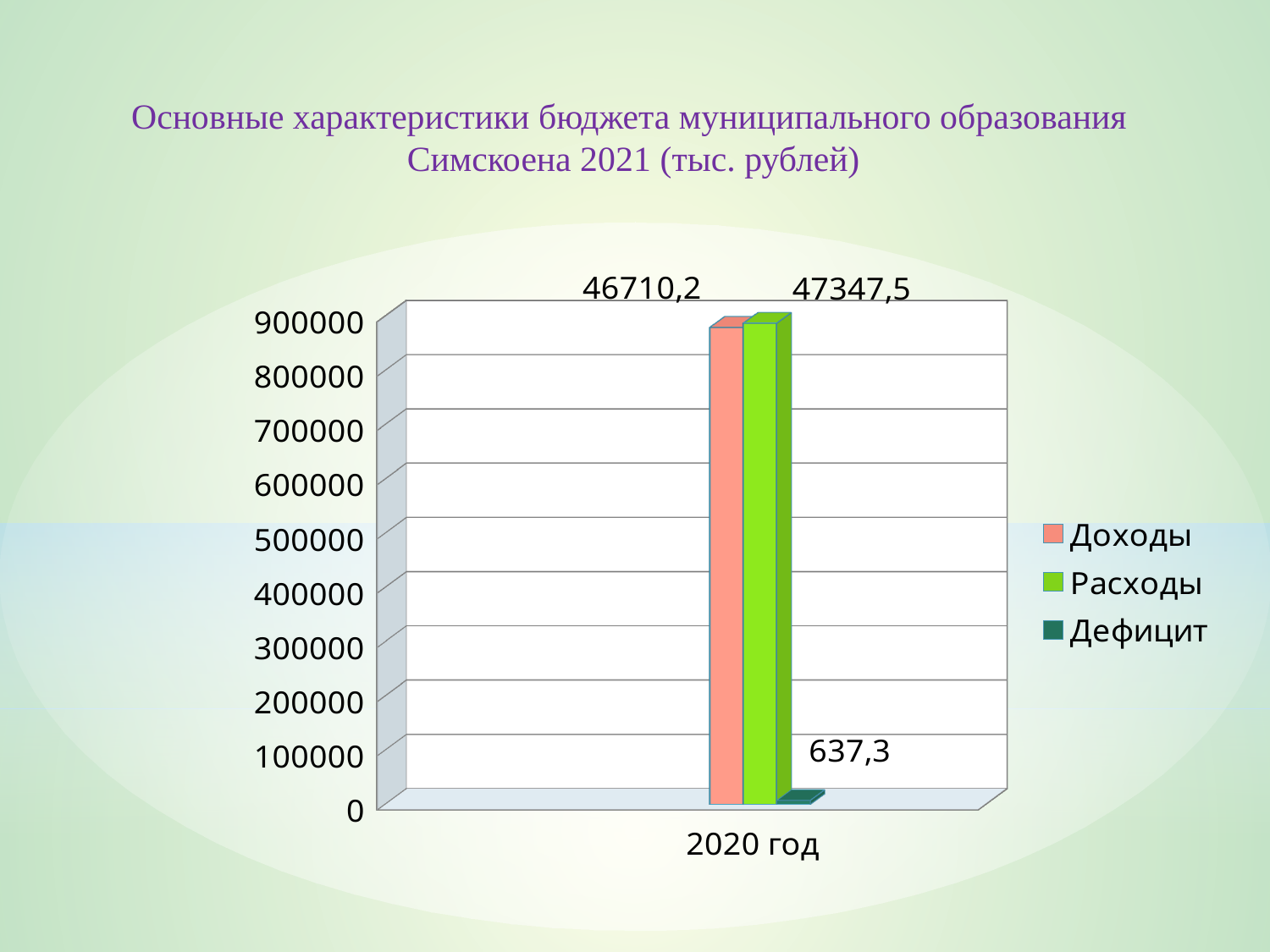
What is the value of Доходы for 2020 год? 46710,2 Which is larger for 2020 год, Доходы or Расходы? Расходы What is the difference between Расходы and Доходы for 2020 год? 637,3 What category label is shown on the x axis? 2020 год Which series is shown in green in the legend? Расходы How many series does the legend list? 3 What is the value of Расходы for 2020 год? 47347,5 Which series has the lowest value for 2020 год? Дефицит Which series has the highest value for 2020 год? Расходы What kind of chart is shown on the slide? Bar chart How many categories are shown on the x axis? 1 What is the value of Дефицит for 2020 год? 637,3